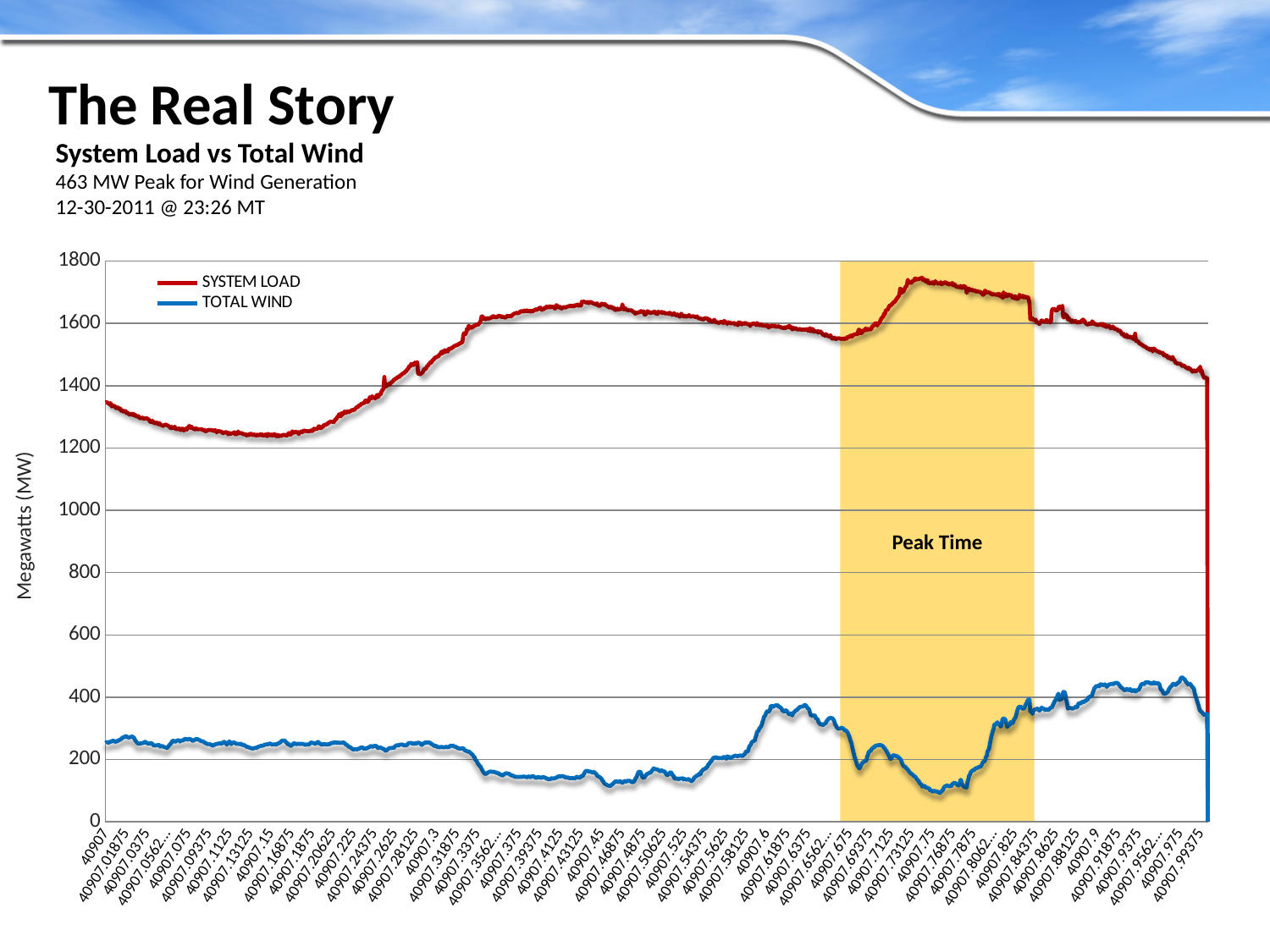
Is the highest value of SYSTEM LOAD greater or less than 1600? greater What type of chart is shown on the slide? line chart Does SYSTEM LOAD rise or fall between the left edge of the chart and the start of the Peak Time band? rise Does SYSTEM LOAD rise or fall from the end of the Peak Time band to the right edge of the chart? fall Which series has higher values throughout the chart, SYSTEM LOAD or TOTAL WIND? SYSTEM LOAD What is the label on the vertical axis? Megawatts (MW) Is the lowest value of TOTAL WIND within the Peak Time band greater or less than 200? less Is the SYSTEM LOAD value at the left edge of the chart greater or less than 1400? less What peak value for wind generation is stated in the chart subtitle? 463 MW How many series does the legend list? 2 What are the two series named in the legend? SYSTEM LOAD and TOTAL WIND